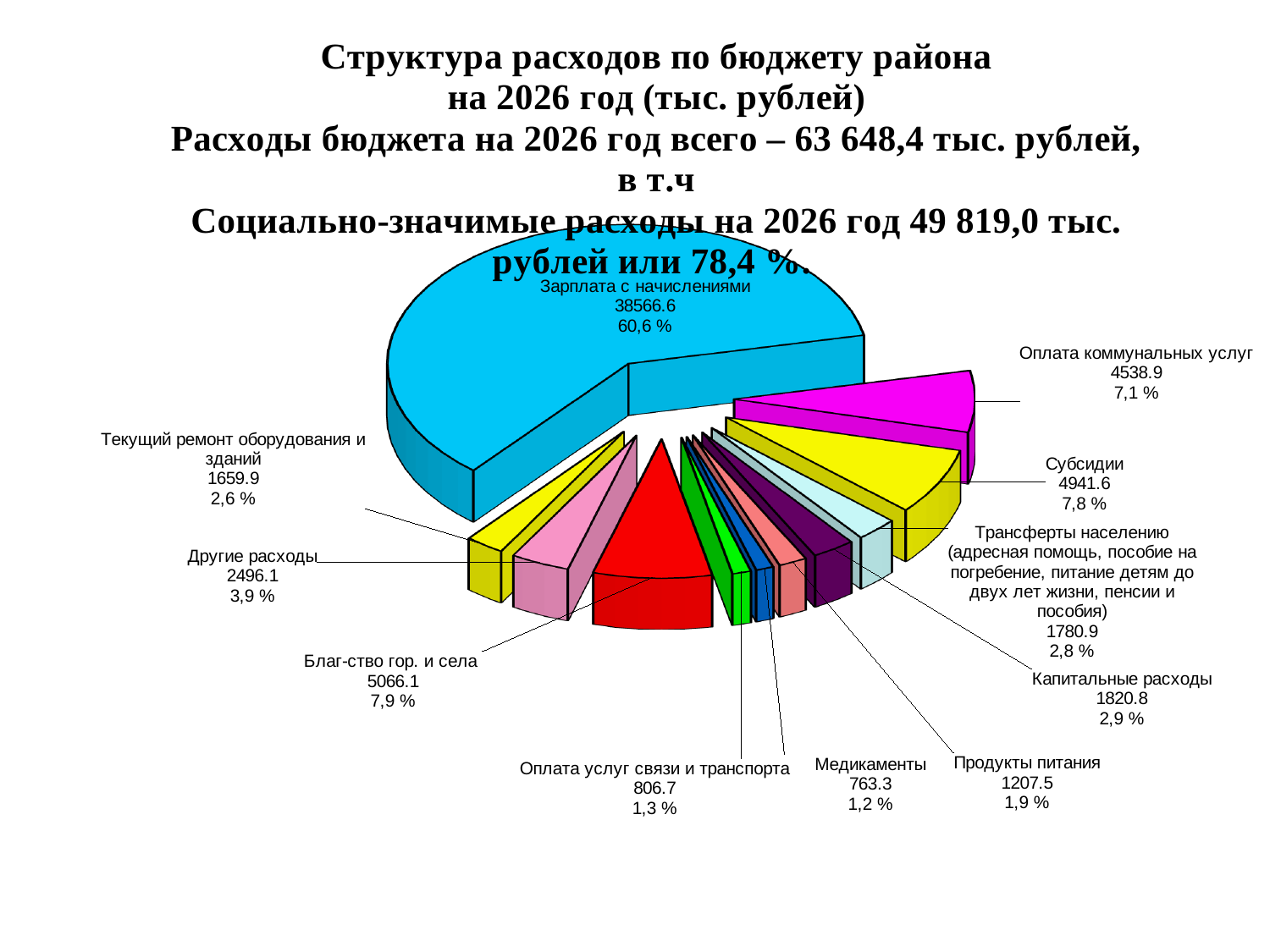
Which is larger: the value for Оплата услуг связи и транспорта or the value for Медикаменты? Оплата услуг связи и транспорта What kind of chart is shown on the slide? pie chart What share of the pie does Зарплата с начислениями represent? 60,6 % Which category has the largest slice? Зарплата с начислениями What is the value for Продукты питания? 1207.5 What is the value for Субсидии? 4941.6 Which category has the smallest slice? Медикаменты What is the difference between the values for Субсидии and Оплата коммунальных услуг? 402.7 How many categories (slices) does the pie chart have? 11 According to the slide title, what is the total budget expenditure for 2026? 63 648,4 тыс. рублей What is the value for Зарплата с начислениями? 38566.6 What share of the pie does Благ-ство гор. и села represent? 7,9 %